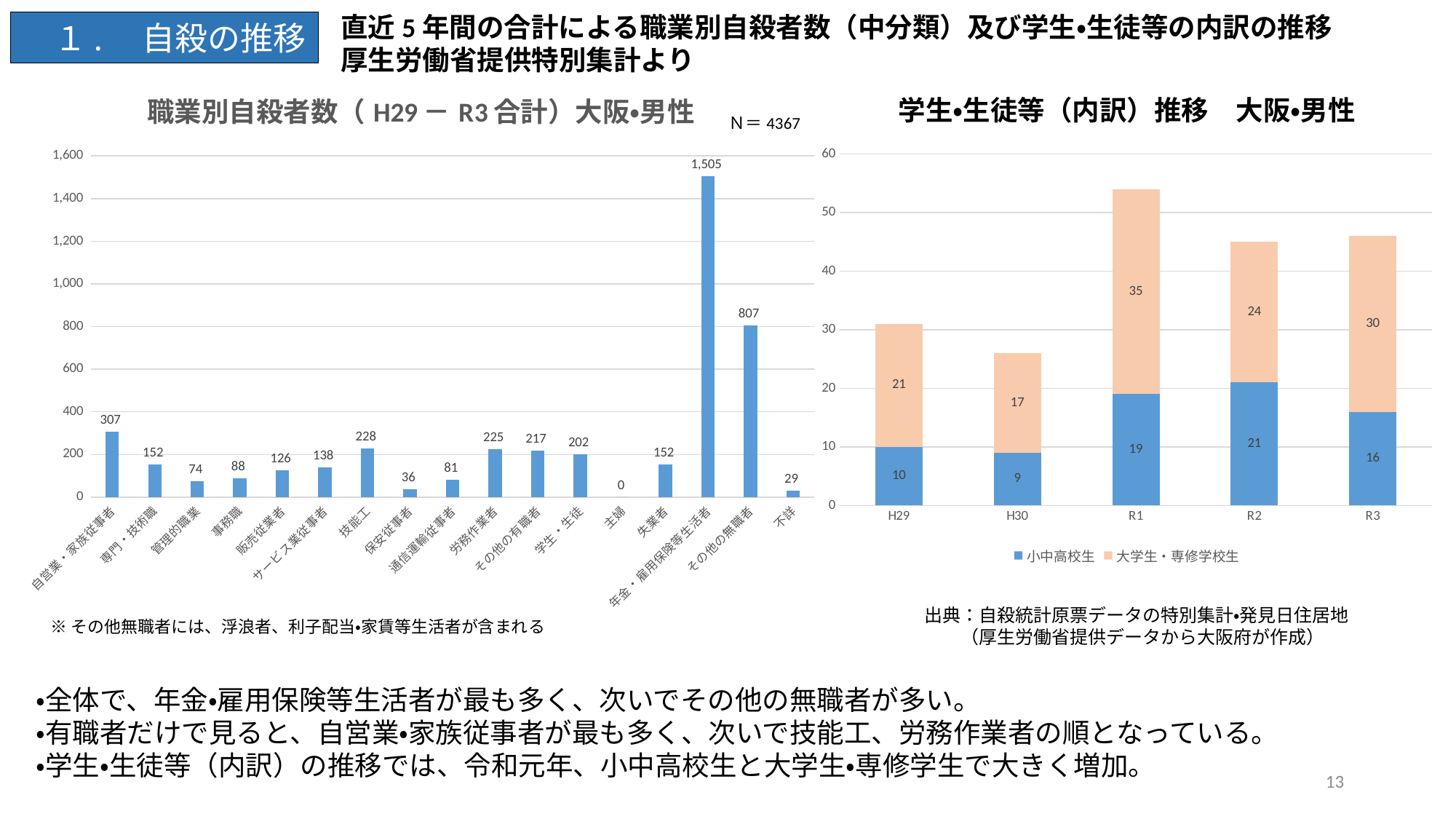
How many series does the legend of the right chart (学生・生徒等（内訳）推移) list? 2 In the left chart (職業別自殺者数), what is the value for 年金・雇用保険等生活者? 1,505 In the left chart (職業別自殺者数), which category has the lowest value? 主婦 In the right chart (学生・生徒等（内訳）推移), what is the total of the stacked bar for R2? 45 What kind of chart is the right chart (学生・生徒等（内訳）推移)? Stacked bar chart In the left chart (職業別自殺者数), what is the value for 技能工? 228 In the right chart (学生・生徒等（内訳）推移), what is the value for 大学生・専修学校生 in R1? 35 In the right chart (学生・生徒等（内訳）推移), which year has the highest total? R1 In the left chart (職業別自殺者数), what is the difference between 年金・雇用保険等生活者 and その他の無職者? 698 In the left chart (職業別自殺者数), which category has the highest value? 年金・雇用保険等生活者 In the left chart (職業別自殺者数), which is larger, 自営業・家族従事者 or 労務作業者? 自営業・家族従事者 How many categories are shown on the x axis of the left chart (職業別自殺者数)? 17